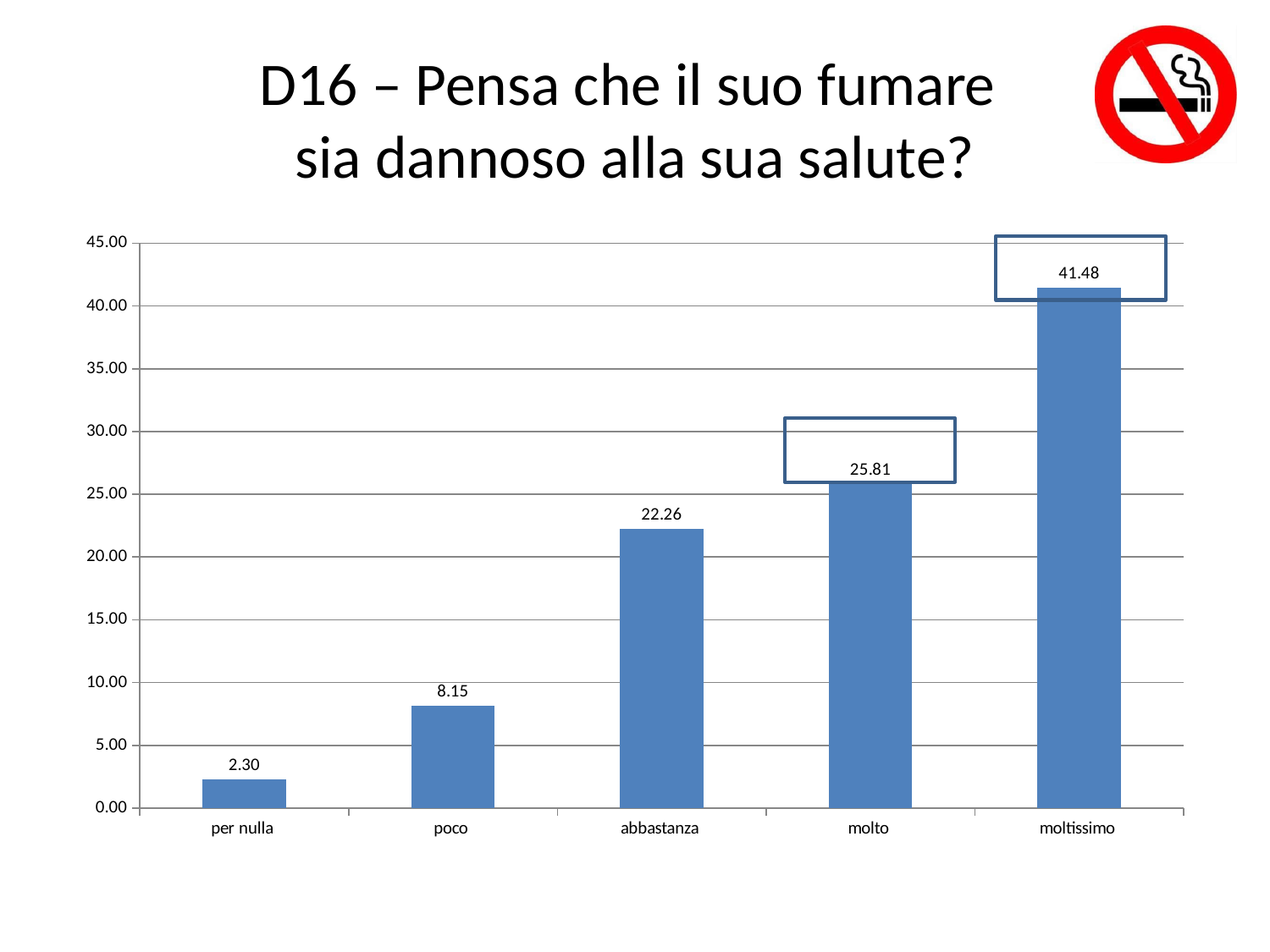
Is the value for "molto" greater or less than 25.00? greater What is the value for "per nulla"? 2.30 Which category has the lowest value? per nulla What is the value for "abbastanza"? 22.26 What is the value for "moltissimo"? 41.48 Which category has the highest value? moltissimo What is the difference between the values for "moltissimo" and "molto"? 15.67 What is the value for "poco"? 8.15 How many categories are shown on the x axis? 5 Which is larger, the value for "abbastanza" or the value for "molto"? molto What kind of chart is shown on the slide? bar chart Do the values rise or fall from "per nulla" to "moltissimo"? rise